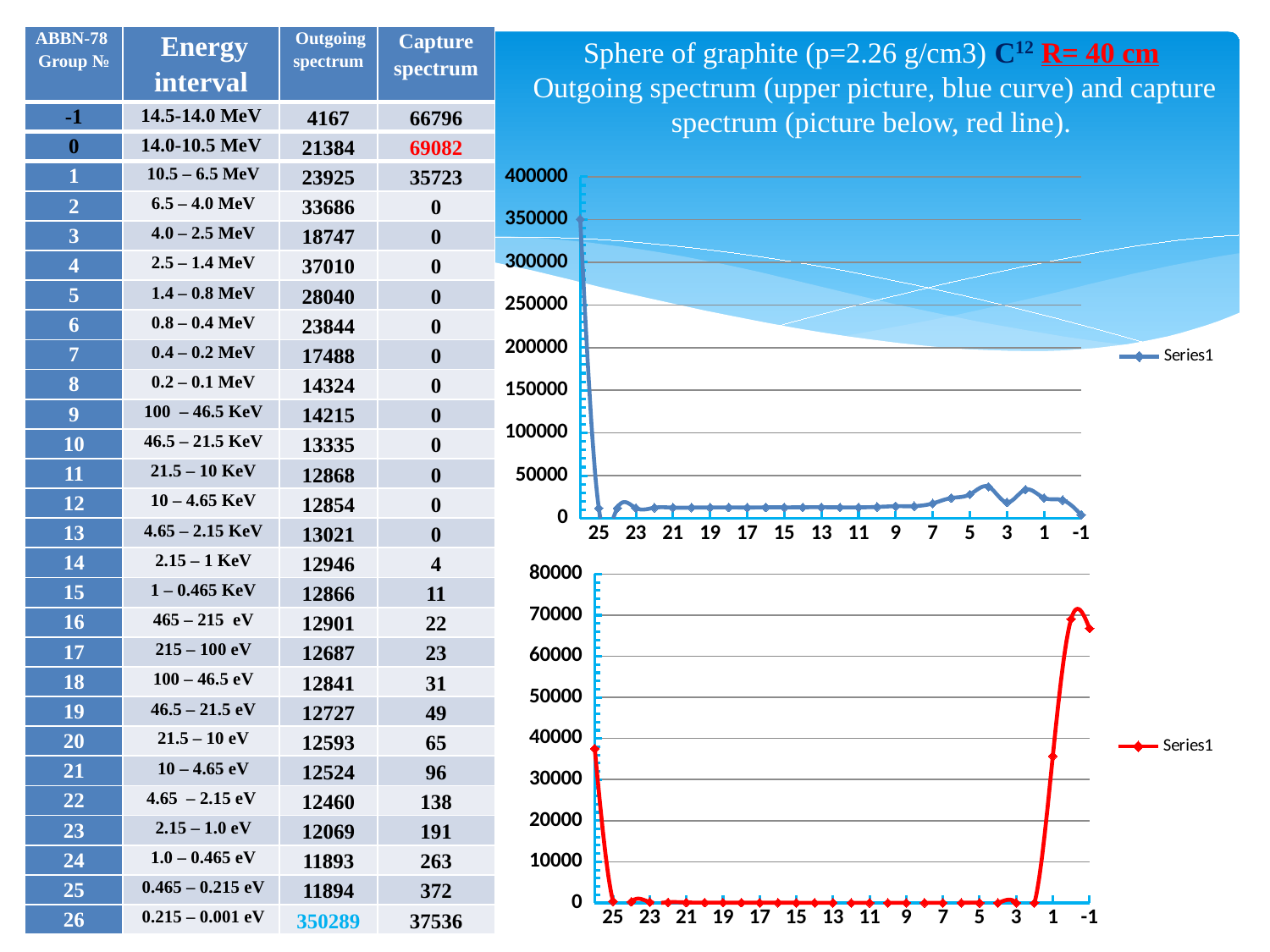
What is the legend entry shown for the lower chart? Series1 In the upper chart, is the value at x = 1 greater or less than 50000? less In the upper chart, is the value at x = 15 greater or less than 50000? less How many series does the legend of the upper chart list? 1 What kind of chart is the lower chart on the slide? line chart What is the highest value shown on the y axis of the lower chart? 80000 In the upper chart, is the value at x = 25 greater or less than 300000? less What kind of chart is the upper chart on the slide? line chart